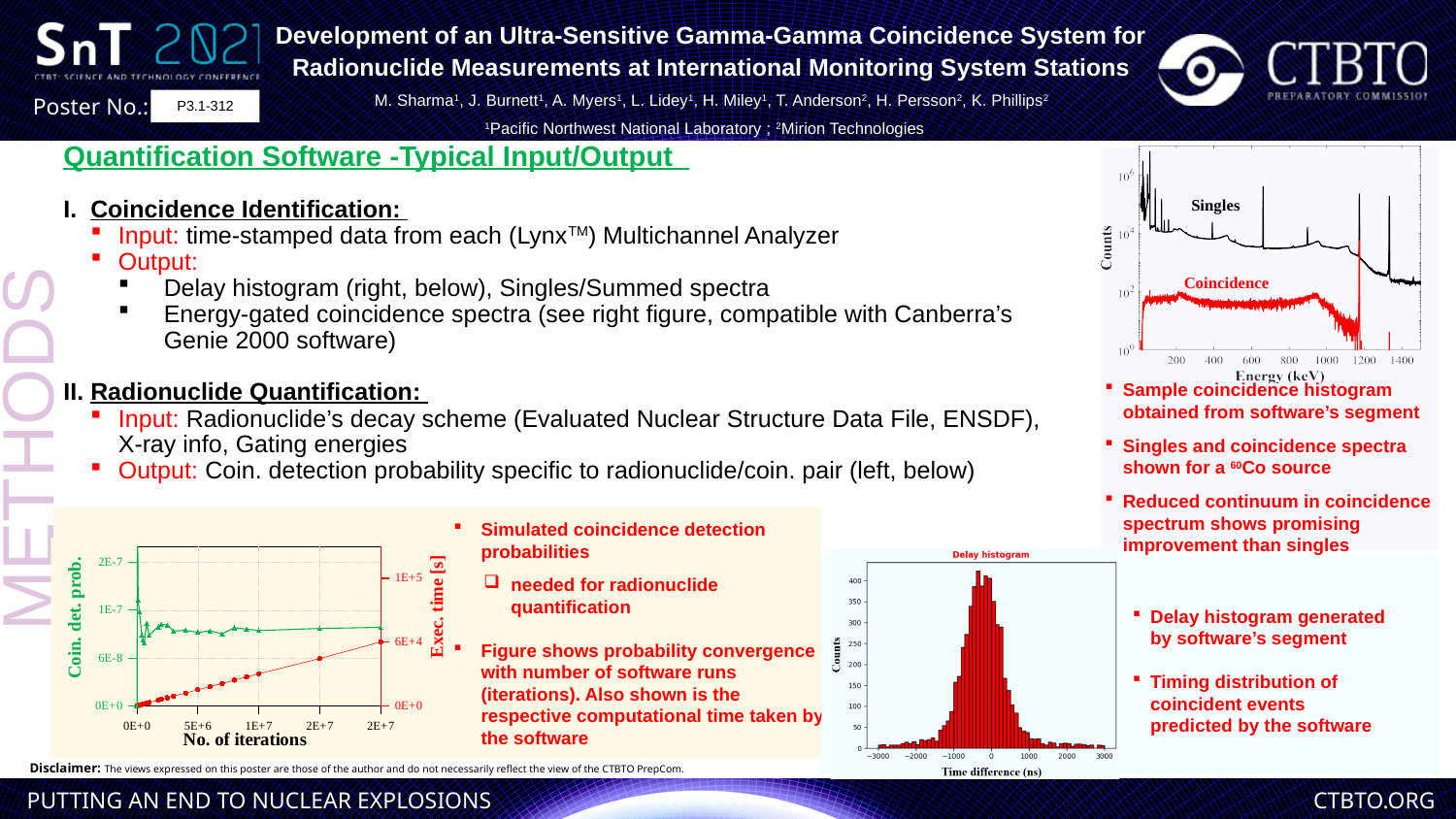
In the top-right spectrum chart, which of the two labelled spectra, Singles or Coincidence, has higher counts? Singles What kind of chart is the bottom-left chart of coincidence detection probability versus number of iterations? line chart In the Delay histogram, is the count of the tallest bar greater or less than 300? greater In the Delay histogram, is the count at a time difference of 3000 ns greater or less than 50? less What kind of chart is the Delay histogram? bar chart In the bottom-left chart, is the Coin. det. prob. value at 2E+7 iterations greater or less than 6E-8? greater What is the title of the chart at the bottom centre of the slide? Delay histogram How many spectra are labelled in the top-right spectrum chart? 2 In the top-right spectrum chart, what is the label of the x axis? Energy (keV) In the bottom-left chart, what is the label of the x axis? No. of iterations In the bottom-left chart, does the Exec. time series rise or fall as the number of iterations increases? rise